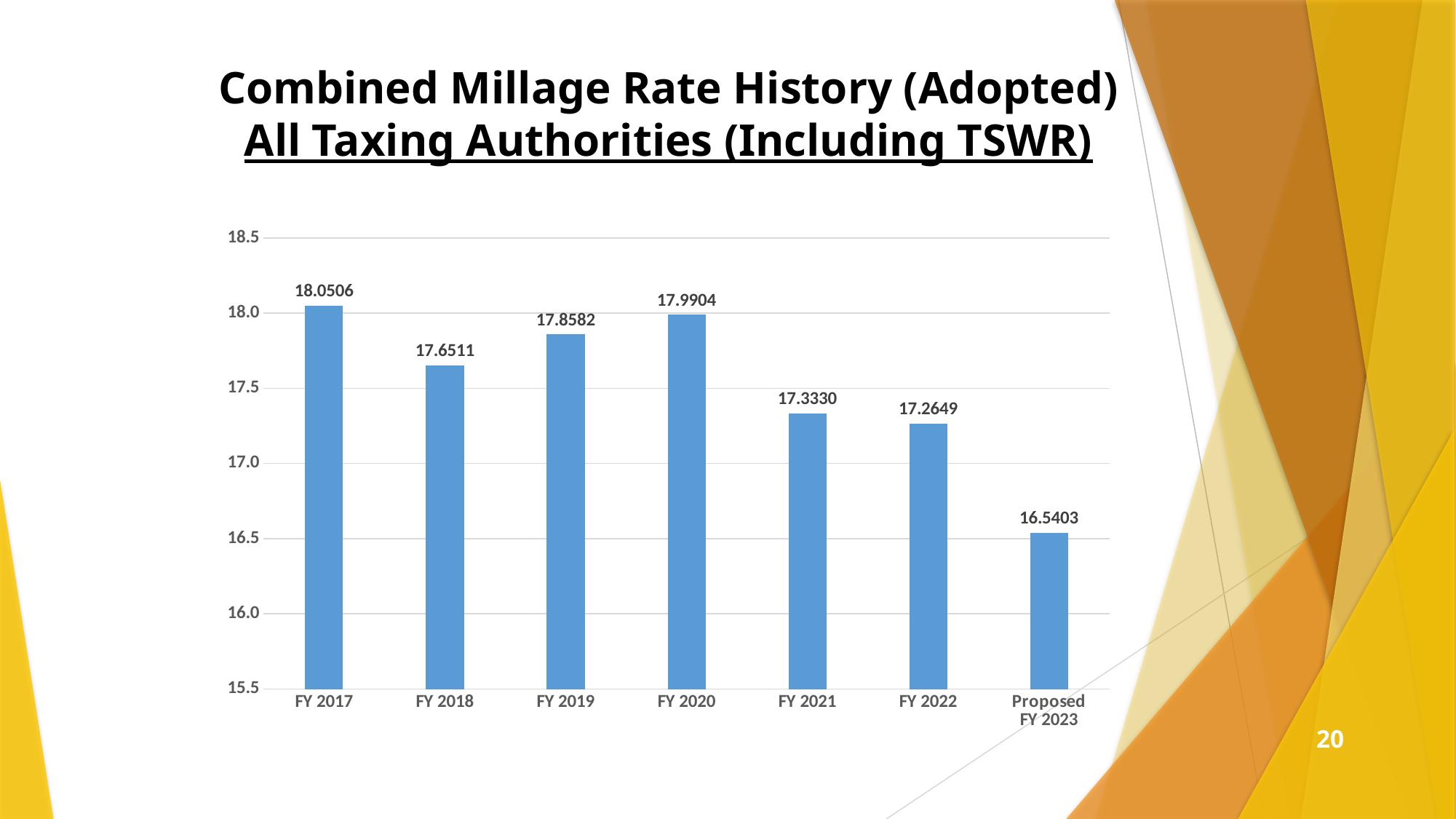
Overall, do the values rise or fall from FY 2017 to Proposed FY 2023? fall Which category has the lowest value on the chart? Proposed FY 2023 Which fiscal year has the highest combined millage rate? FY 2017 Is the value for FY 2018 greater or less than 17.5? greater What is the combined millage rate shown for FY 2017? 18.0506 How many fiscal years are shown on the chart? 7 What is the value shown for Proposed FY 2023? 16.5403 What is the difference between the FY 2017 value and the Proposed FY 2023 value? 1.5103 What type of chart is used on this slide? bar chart What is the value shown for FY 2021? 17.3330 By how much does the FY 2022 value exceed the Proposed FY 2023 value? 0.7246 Which is larger, the value for FY 2019 or the value for FY 2020? FY 2020